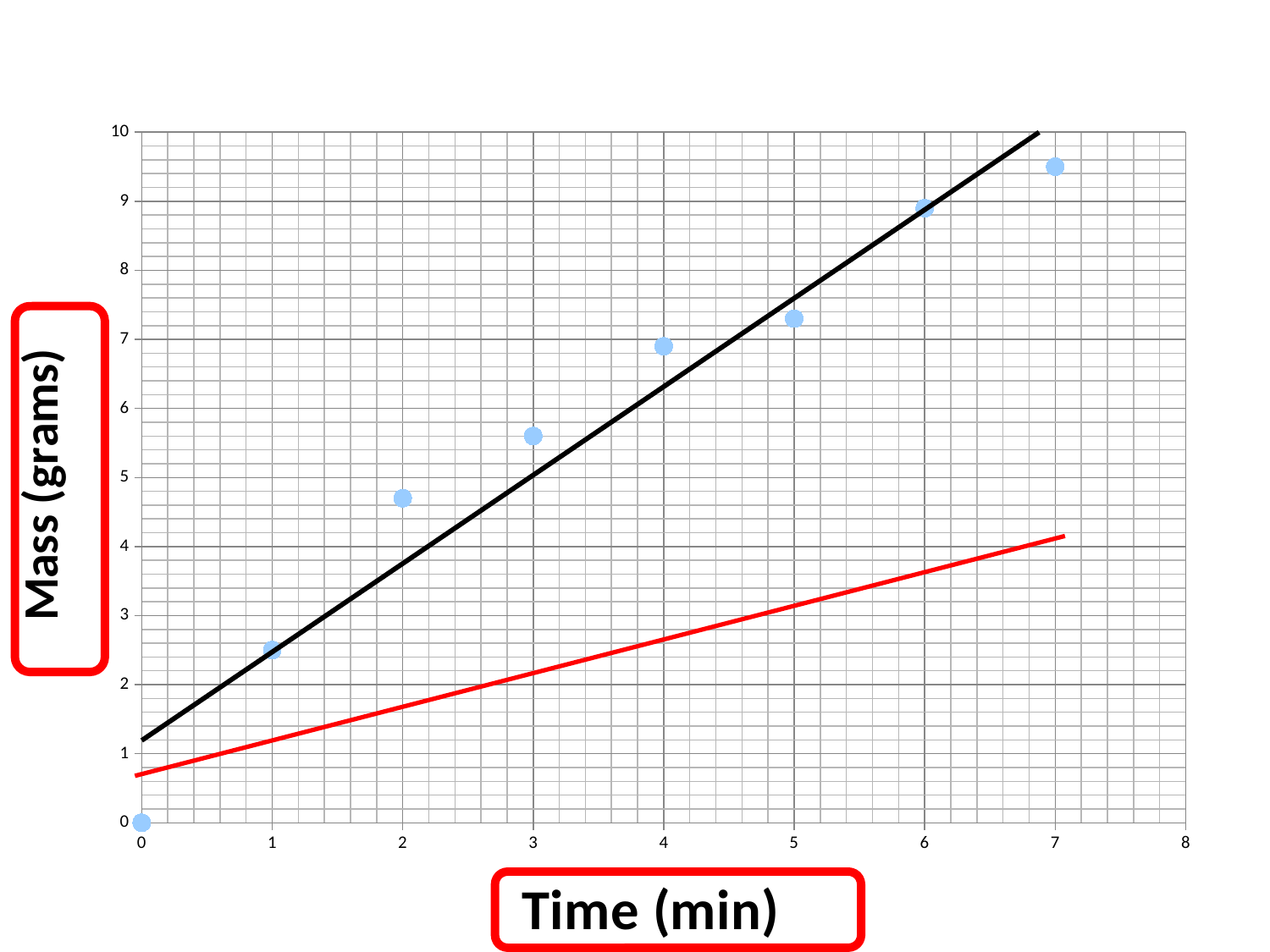
What is the label of the y axis? Mass (grams) How many data points are plotted on the chart? 8 At which time is the plotted mass lowest? 0 Do the plotted mass values rise or fall as time increases? rise Which has the larger mass, the point at time 3 min or the point at time 6 min? time 6 min What is the label of the x axis? Time (min) What is the mass at time 0 min? 0 Is the mass at time 2 min greater or less than 4? greater What kind of chart is shown on the slide? scatter plot Is the mass at time 1 min greater or less than 3? less At which time is the plotted mass highest? 7 Is the mass at time 5 min greater or less than 7? greater